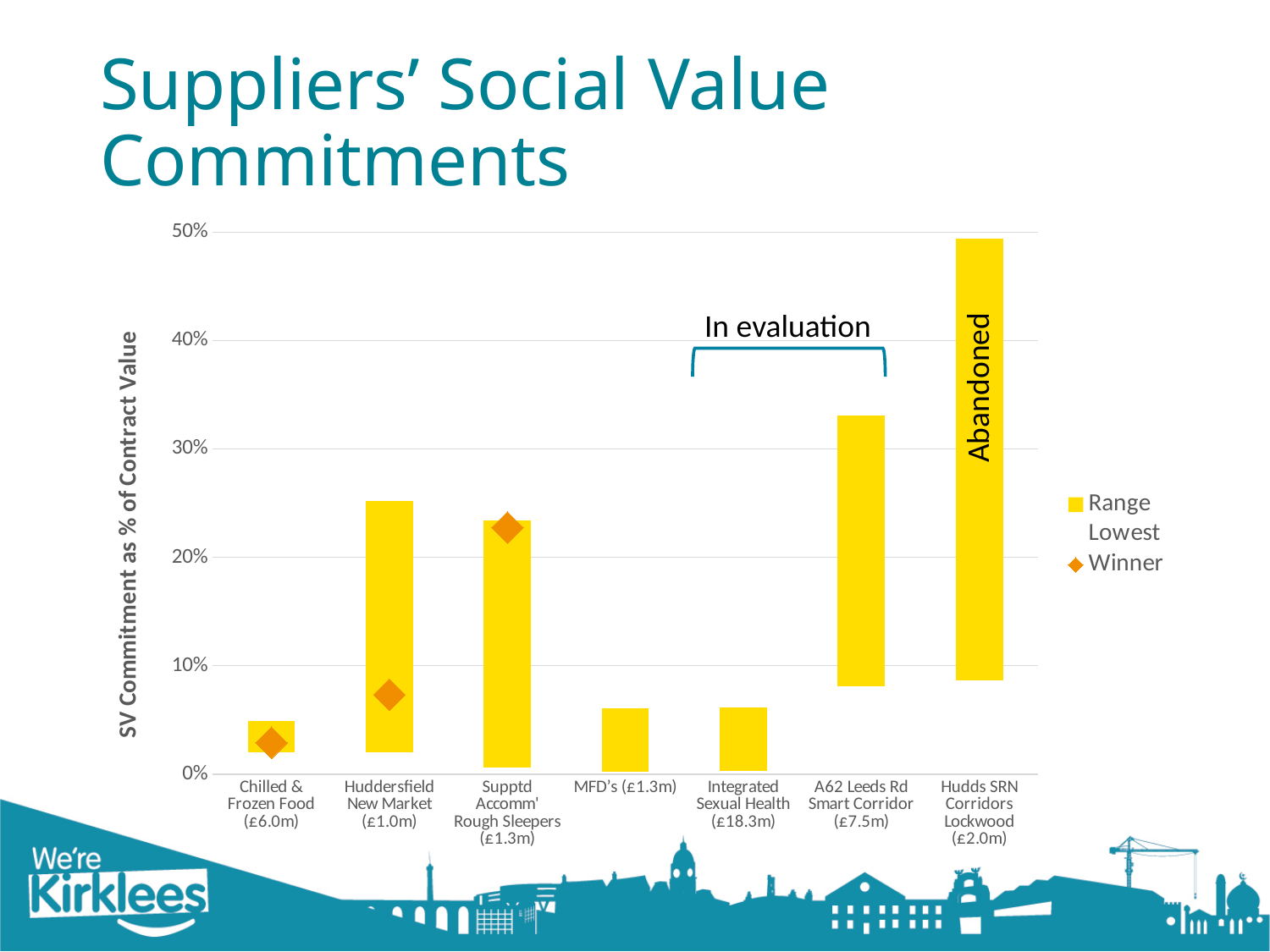
Is the Winner value for Huddersfield New Market (£1.0m) greater or less than 10%? less Is the top of the range bar for Integrated Sexual Health (£18.3m) greater or less than 10%? less Is the top of the range bar for A62 Leeds Rd Smart Corridor (£7.5m) greater or less than 30%? greater Which contract has the highest Winner marker? Supptd Accomm' Rough Sleepers (£1.3m) How many entries does the legend list? 3 What kind of chart is shown on the slide? bar chart Which bar is labelled 'Abandoned'? Hudds SRN Corridors Lockwood (£2.0m) How many contracts (categories) are shown on the x axis? 7 Which contract has the highest top of its range bar? Hudds SRN Corridors Lockwood (£2.0m) What is the label of the y axis? SV Commitment as % of Contract Value